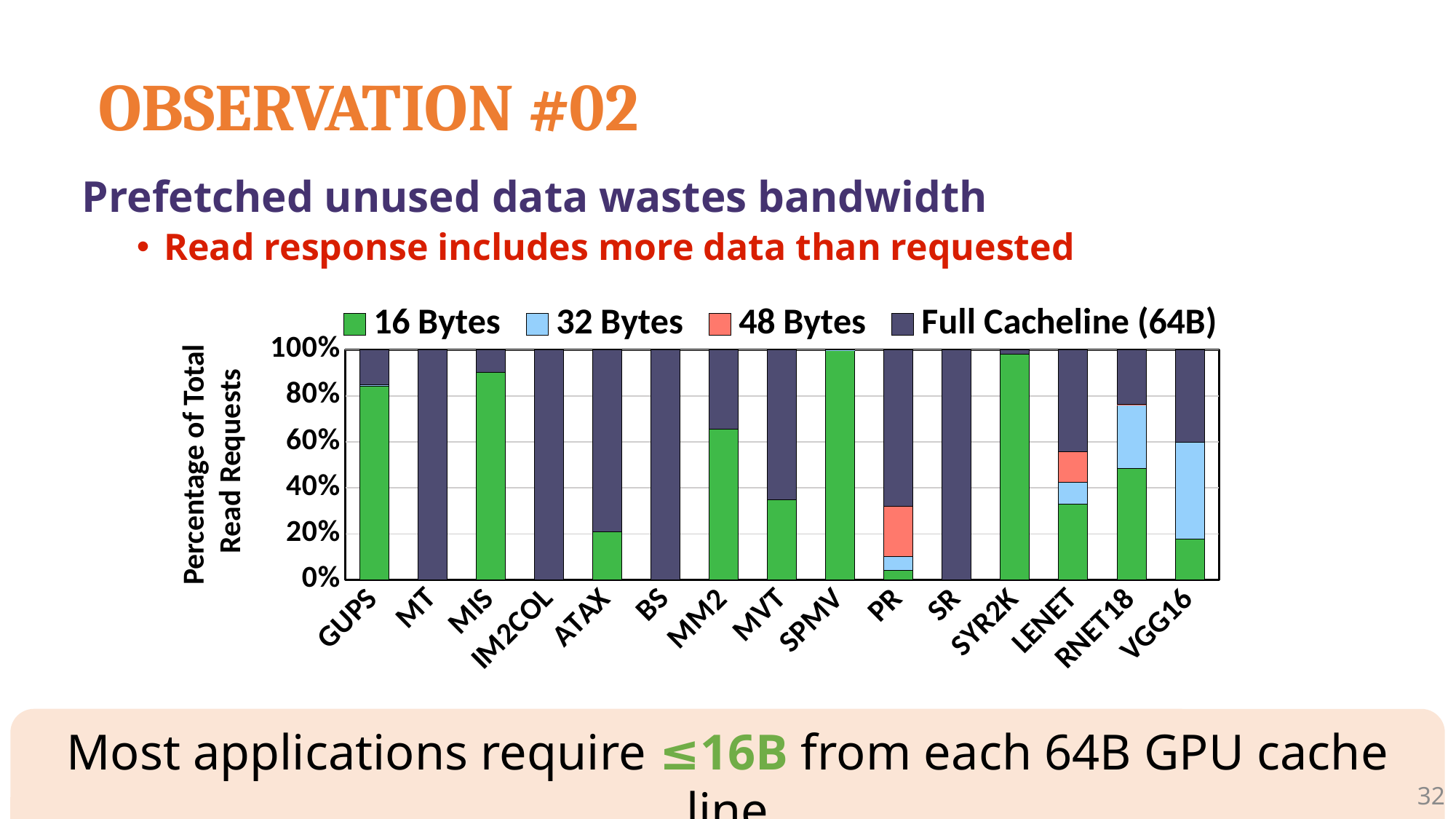
What is the y-axis title of the chart? Percentage of Total Read Requests How many series does the chart's legend list? 4 What are the four series listed in the chart's legend? 16 Bytes, 32 Bytes, 48 Bytes, Full Cacheline (64B) How many applications (categories) are shown on the x axis of the chart? 15 What percentage of read requests for SPMV are 16 Bytes? 100% Is the 16 Bytes value for GUPS greater or less than 80%? greater Which application has the largest 48 Bytes segment? PR Is the 16 Bytes value for MVT greater or less than 40%? less Which application has the larger 16 Bytes share, GUPS or ATAX? GUPS What kind of chart is shown on the slide? Stacked bar chart What percentage of read requests for MT are Full Cacheline (64B)? 100% Is the 16 Bytes value for ATAX greater or less than 40%? less